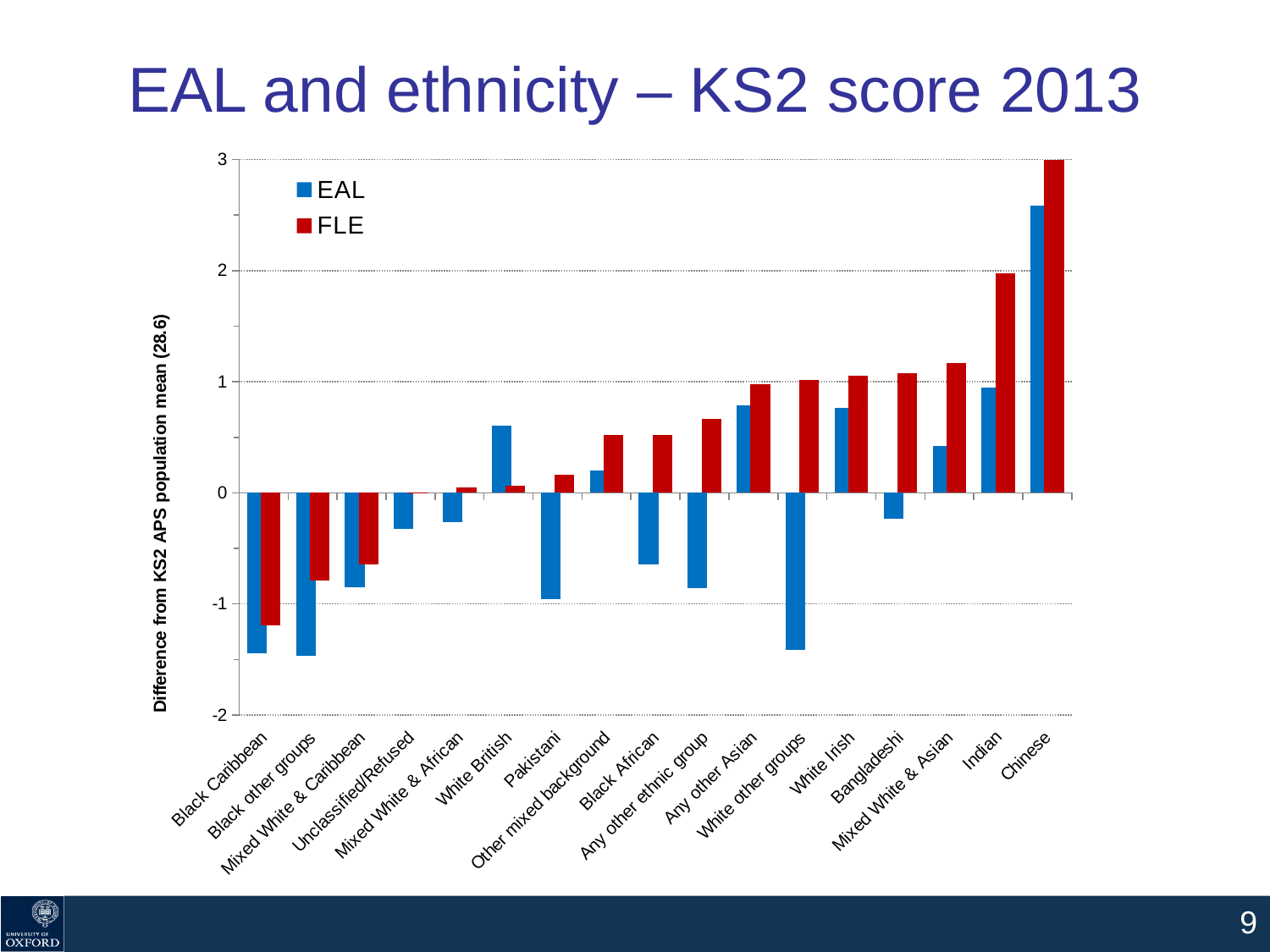
For White British, which series has the larger value, EAL or FLE? EAL Which category has the highest FLE value? Chinese How many ethnic group categories are shown on the x axis? 17 Which category has the lowest FLE value? Black Caribbean Which category has the highest EAL value? Chinese Is the EAL value for White other groups greater or less than -1? less How many series does the legend list? 2 Do the FLE values generally rise or fall moving left to right along the x axis? rise For Indian, which series has the larger value, EAL or FLE? FLE Is the FLE value for Black Caribbean greater or less than -1? less Is the EAL value for Chinese greater or less than 2? greater What kind of chart is shown on the slide? bar chart